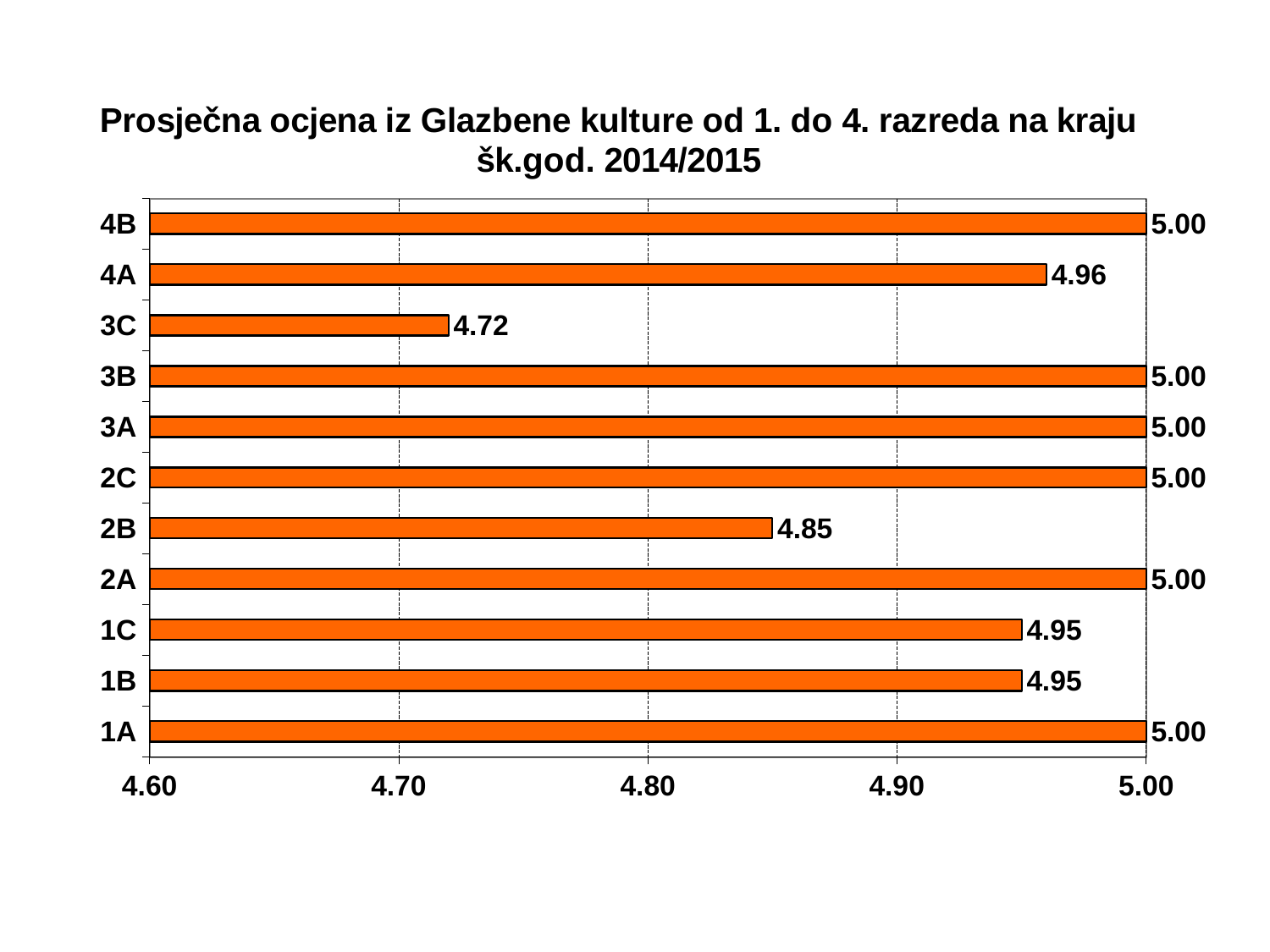
What is the difference between the values for 4A and 3C? 0.24 What kind of chart is this? bar chart What is the difference between the values for 2B and 3C? 0.13 What is the value for 2B? 4.85 What is the value for 3C? 4.72 Which is larger, the value for 2B or the value for 1C? 1C How many classes are shown on the chart? 11 Which class has the lowest average grade? 3C How many classes have a value of 5.00? 6 What is the value for 1B? 4.95 What is the value for 4A? 4.96 Is the value for 3C greater or less than 4.80? less